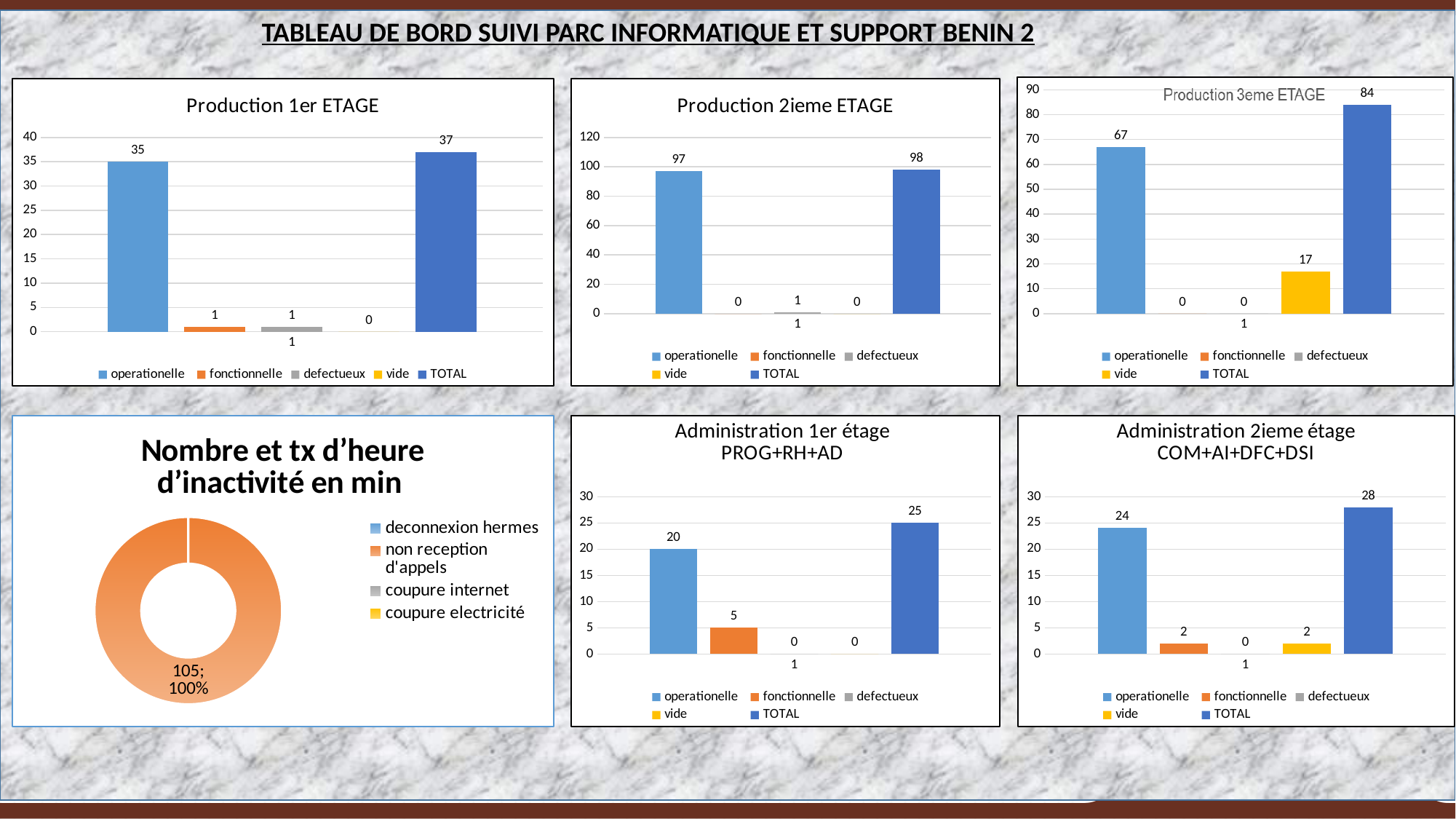
In the 'Administration 1er étage PROG+RH+AD' chart, what is the value for fonctionnelle? 5 In the 'Administration 2ieme étage COM+AI+DFC+DSI' chart, what is the value for TOTAL? 28 In the 'Production 1er ETAGE' chart, what is the value for TOTAL? 37 In the 'Production 3eme ETAGE' chart, what is the value for vide? 17 In the 'Nombre et tx d'heure d'inactivité en min' chart, what share does the single slice represent? 100% In the 'Production 3eme ETAGE' chart, which series has the highest value? TOTAL In the 'Production 1er ETAGE' chart, what is the value for operationelle? 35 In the 'Administration 2ieme étage COM+AI+DFC+DSI' chart, which is larger, operationelle or fonctionnelle? operationelle In the 'Production 2ieme ETAGE' chart, what is the value for operationelle? 97 In the 'Production 2ieme ETAGE' chart, what is the difference between TOTAL and operationelle? 1 How many series does the legend of the 'Production 1er ETAGE' chart list? 5 In the 'Administration 1er étage PROG+RH+AD' chart, what is the difference between TOTAL and operationelle? 5